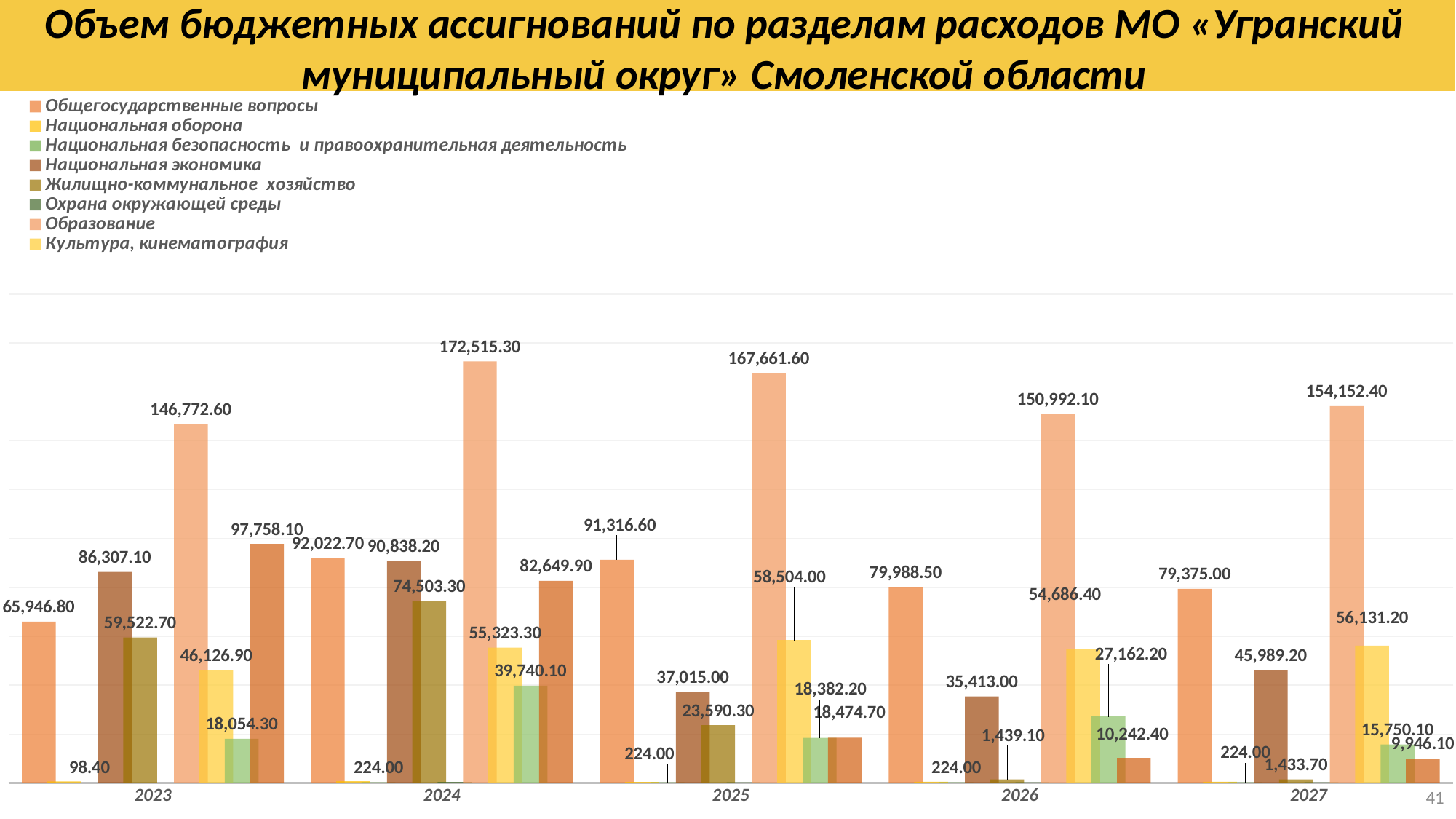
Do the values for Жилищно-коммунальное хозяйство rise or fall from 2024 to 2027? Fall How many series does the legend list? 8 What is the value for Образование in 2024? 172,515.30 What is the difference between the Образование values for 2024 and 2025? 4,853.70 What is the value for Общегосударственные вопросы in 2023? 65,946.80 Which year has the larger value for Национальная экономика, 2023 or 2024? 2024 What is the value for Национальная экономика in 2027? 45,989.20 What kind of chart is shown on the slide? Bar chart In which year is the value for Образование the lowest? 2023 How many years are shown along the x axis of the chart? 5 In which year is the value for Образование the highest? 2024